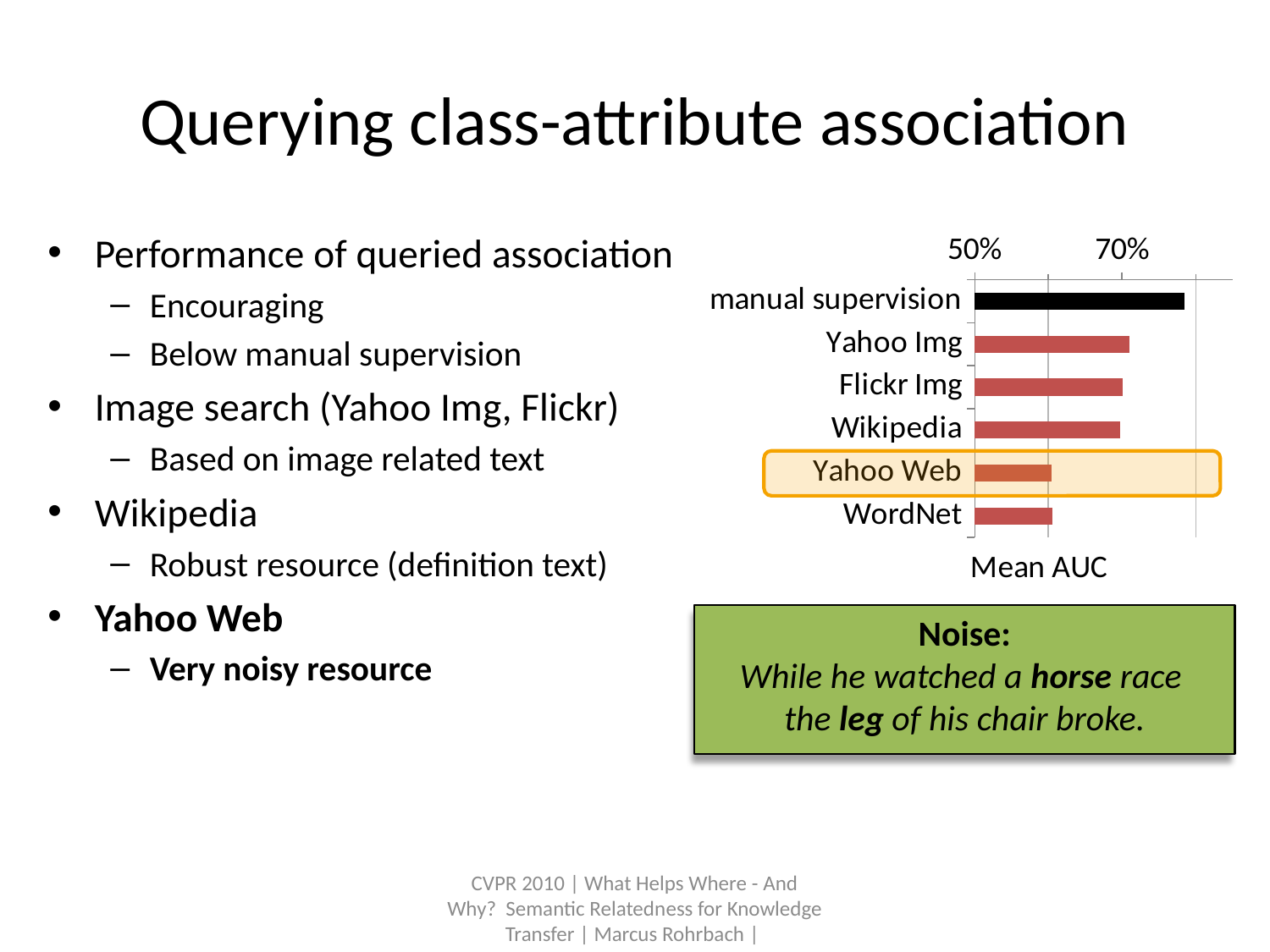
Which has a higher Mean AUC, Flickr Img or WordNet? Flickr Img What is the label of the chart's horizontal axis? Mean AUC Is the value for Wikipedia greater or less than 50%? greater How many categories are plotted in the chart? 6 Is the value for Yahoo Web greater or less than 70%? less What kind of chart is shown on the slide? bar chart Is the value for manual supervision greater or less than 70%? greater Which category in the chart is highlighted with an orange box? Yahoo Web Which category has the highest Mean AUC in the chart? manual supervision Which has a higher Mean AUC, Yahoo Img or Yahoo Web? Yahoo Img Which has a higher Mean AUC, manual supervision or Wikipedia? manual supervision